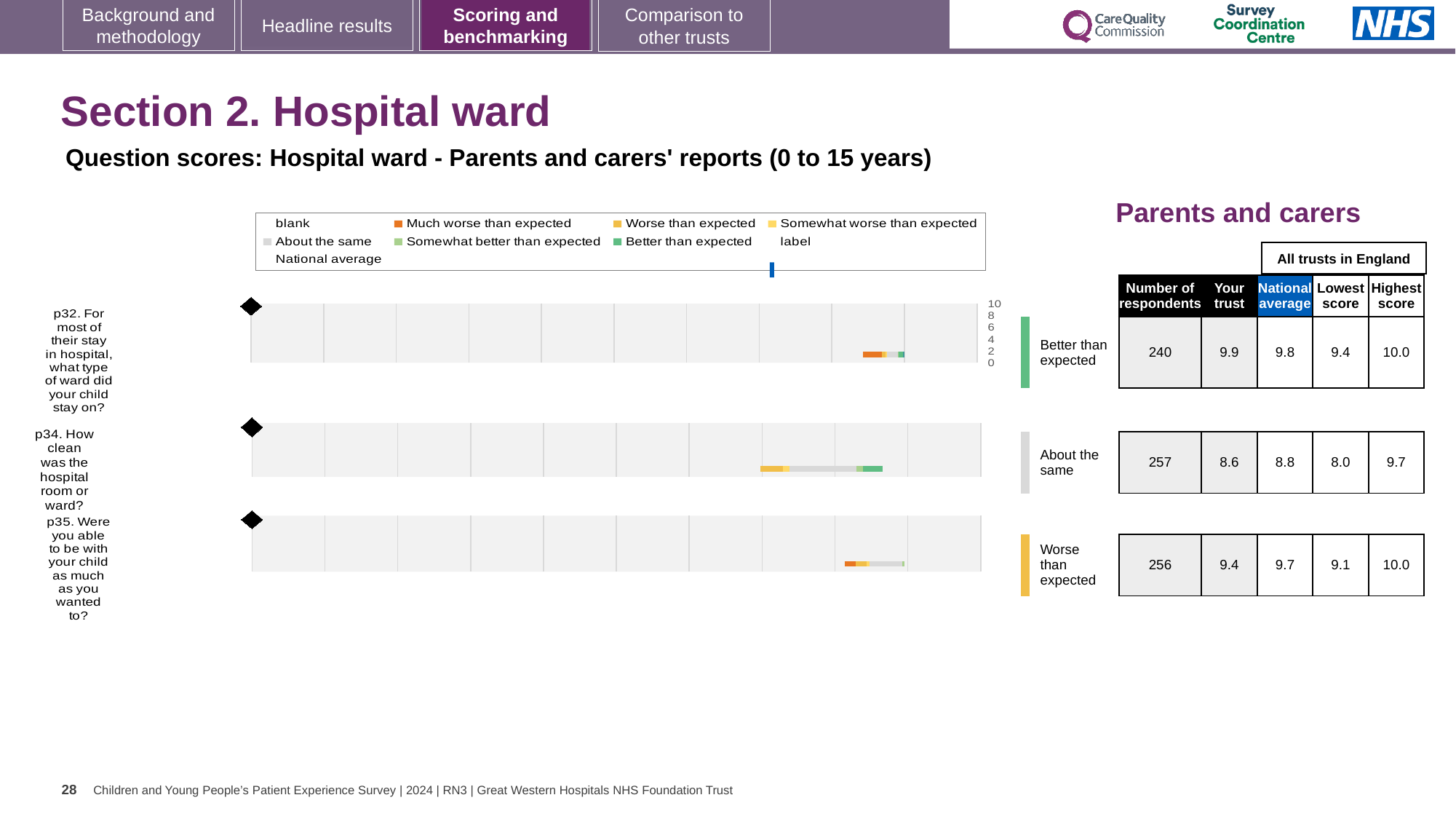
What kind of chart is used to show the question scores on this slide? Bar chart For p34, what is the difference between the national average and the 'Your trust' score? 0.2 What is the 'Your trust' score for p34 (How clean was the hospital room or ward?)? 8.6 For p32, which is larger: the 'Your trust' score or the national average? Your trust What is the national average score for p32 (what type of ward did your child stay on)? 9.8 What is the highest score across all trusts in England for p34? 9.7 How many questions (chart rows) are plotted on the slide? 3 How many respondents answered p35 (Were you able to be with your child as much as you wanted to)? 256 Which question has the highest 'Your trust' score? p32 Which question has the lowest 'Your trust' score? p34 For p35, what is the difference between the highest score and the lowest score across all trusts in England? 0.9 What benchmark category is shown for p35? Worse than expected